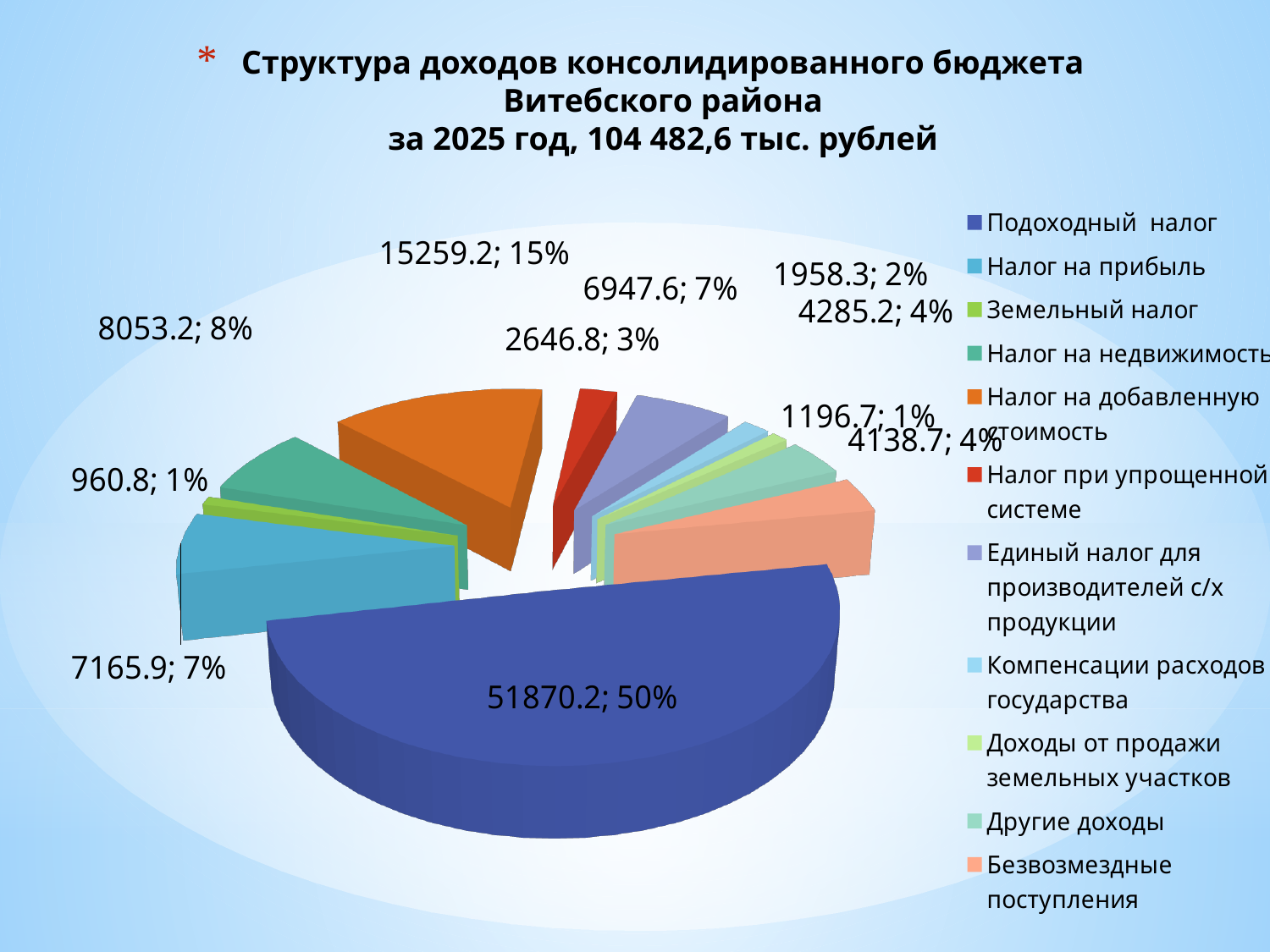
What value is shown for Подоходный налог? 51870.2 What value is shown for Налог при упрощенной системе? 2646.8 What share of the pie does Подоходный налог take? 50% What value is shown for Налог на недвижимость? 8053.2 What total amount is stated in the chart title for 2025? 104 482,6 тыс. рублей How many categories does the legend of the pie chart list? 11 Which is larger: Налог на добавленную стоимость or Налог на недвижимость? Налог на добавленную стоимость What is the difference between the values for Подоходный налог and Налог на добавленную стоимость? 36611.0 What value is shown for Налог на добавленную стоимость? 15259.2 What kind of chart is shown on the slide? pie chart What percentage is shown for Налог на добавленную стоимость? 15% Which category has the largest share of the pie? Подоходный налог